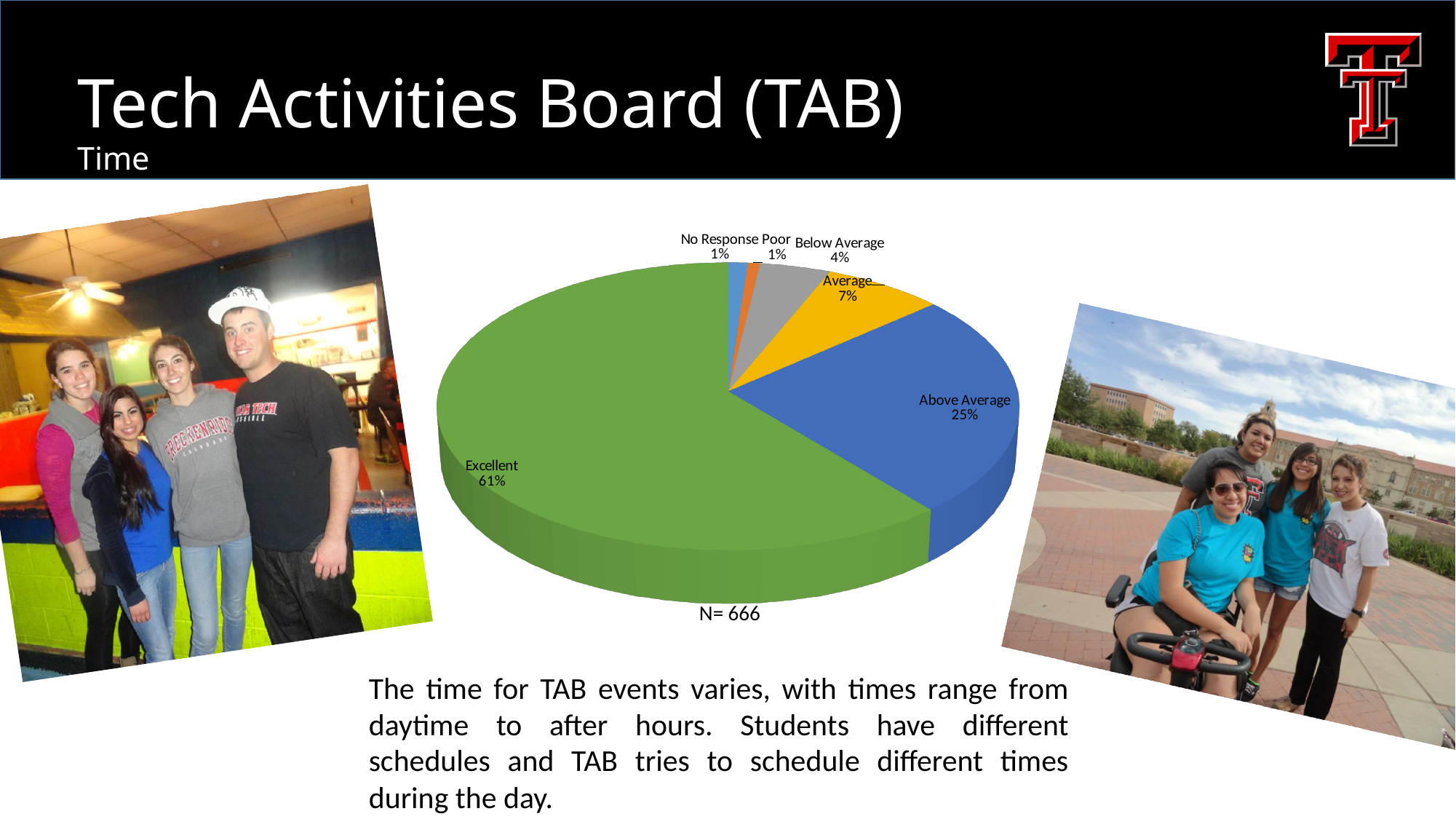
How many slices does the pie chart have? 6 What percentage of responses were Above Average? 25% What percentage of responses rated the time of TAB events as Excellent? 61% What percentage of responses were Poor? 1% What is the difference in percentage points between Excellent and Above Average? 36 What percentage of responses were Average? 7% What is the sample size (N) shown below the pie chart? N= 666 What percentage of responses were Below Average? 4% What colour is the Excellent slice of the pie chart? green Which is larger, the Average slice or the Below Average slice? Average What kind of chart is shown on the slide? pie chart Which category has the largest share of the pie? Excellent